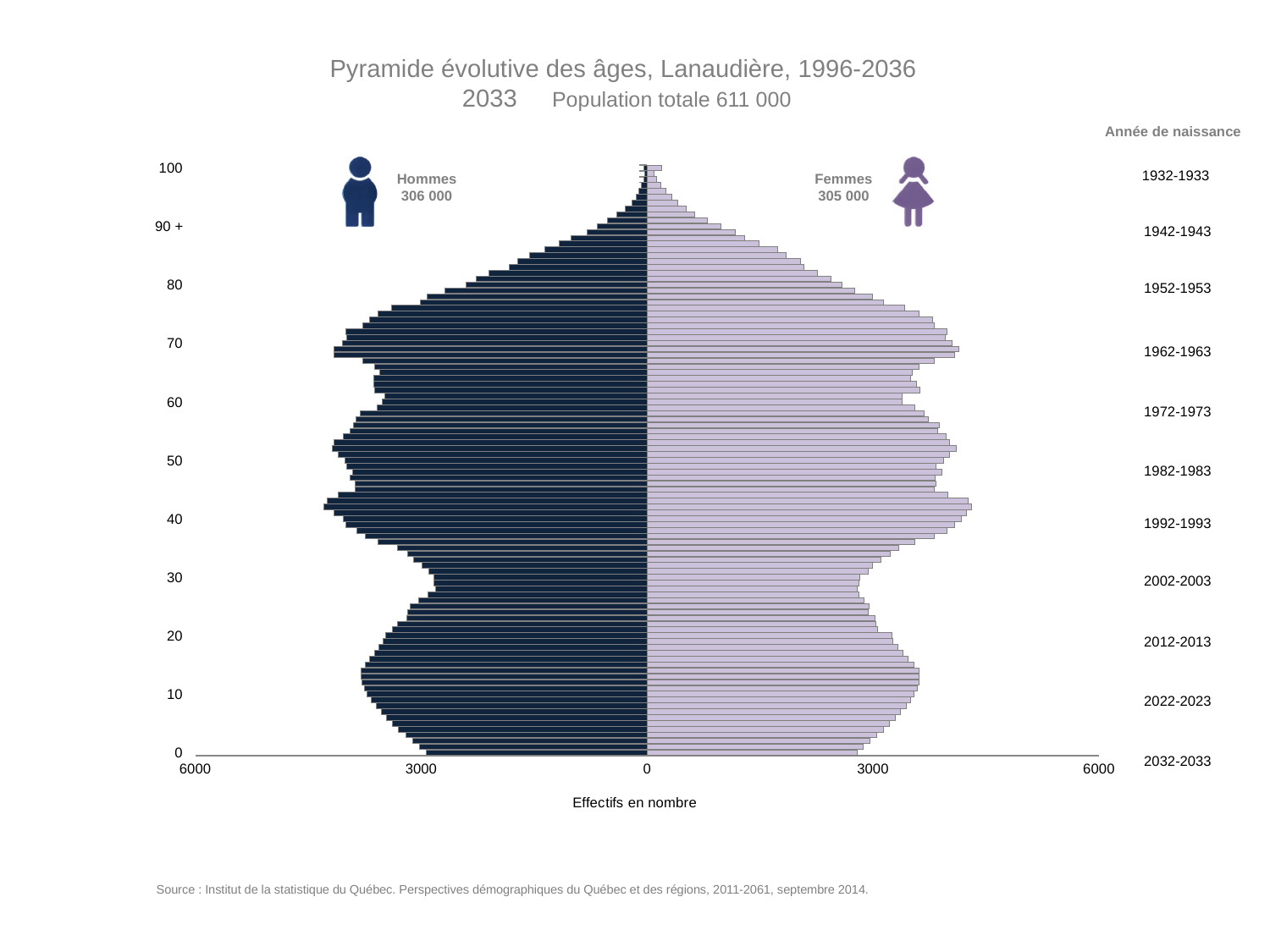
What is the total number of Femmes shown on the chart? 305 000 What is the difference between the Hommes total and the Femmes total? 1 000 Is the value for Femmes at age 30 greater or less than 3000? less What is the Population totale shown for 2033? 611 000 What is the label of the horizontal axis? Effectifs en nombre What kind of chart is shown on the slide? bar chart What is the total number of Hommes shown on the chart? 306 000 Which birth year range is shown opposite age 0 on the right-hand axis? 2032-2033 How many population groups (series) does the chart show? 2 Which group has the larger total, Hommes or Femmes? Hommes Is the value for Femmes at age 90 greater or less than 3000? less Is the value for Hommes at age 70 greater or less than 3000? greater